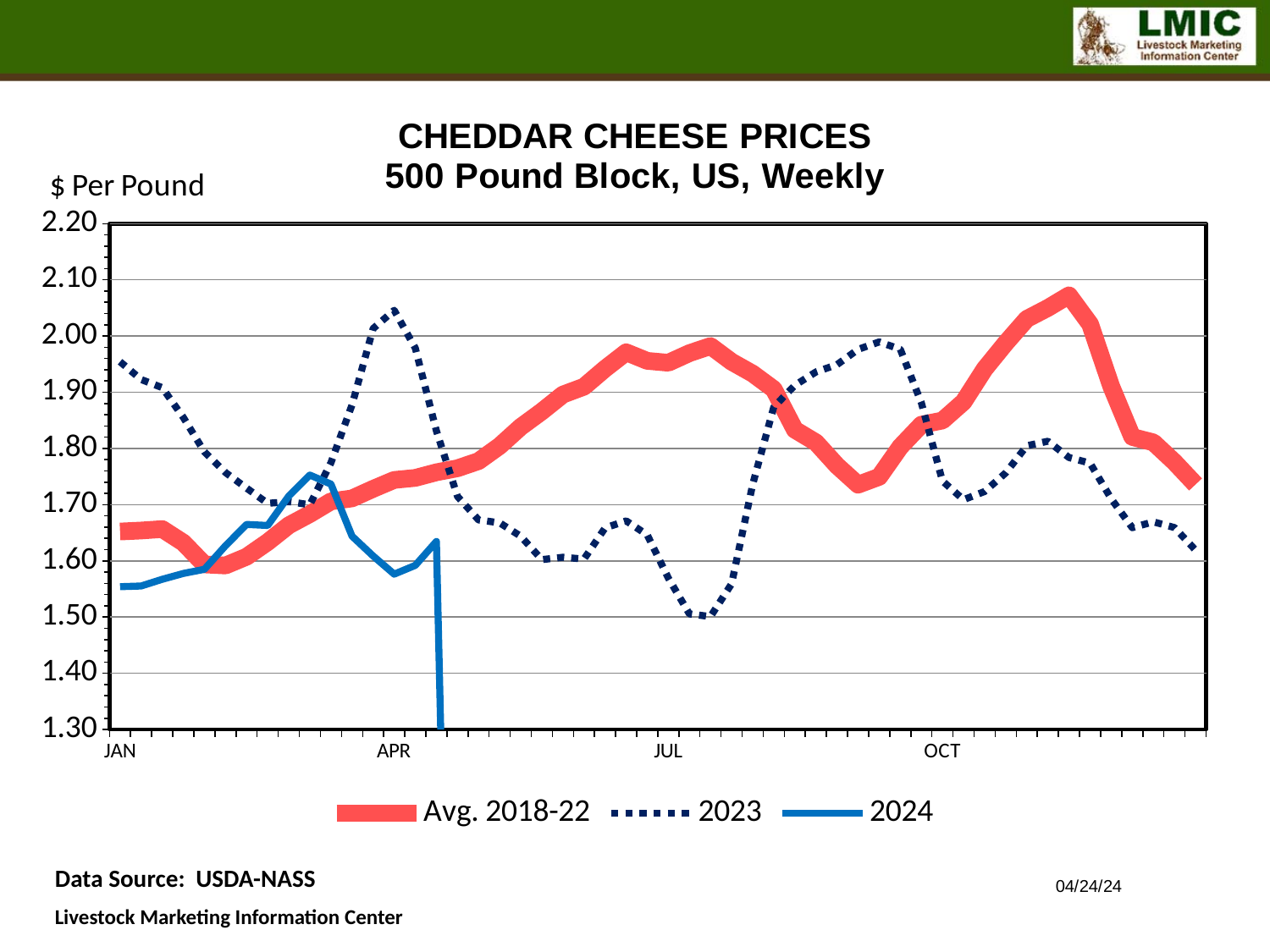
Is the Avg. 2018-22 value at the start of January greater or less than 1.70? less What is the title of the chart? CHEDDAR CHEESE PRICES 500 Pound Block, US, Weekly Does the 2023 line rise or fall from its April peak to early August? fall Is the 2023 value at the start of January greater or less than 1.90? greater What unit is shown on the vertical axis label? $ Per Pound At the start of January, which series is higher: 2023 or 2024? 2023 Is the 2024 value at the start of January greater or less than 1.60? less What kind of chart is shown on the slide? line chart How many series does the legend list? 3 Does the Avg. 2018-22 line rise or fall from January to July? rise